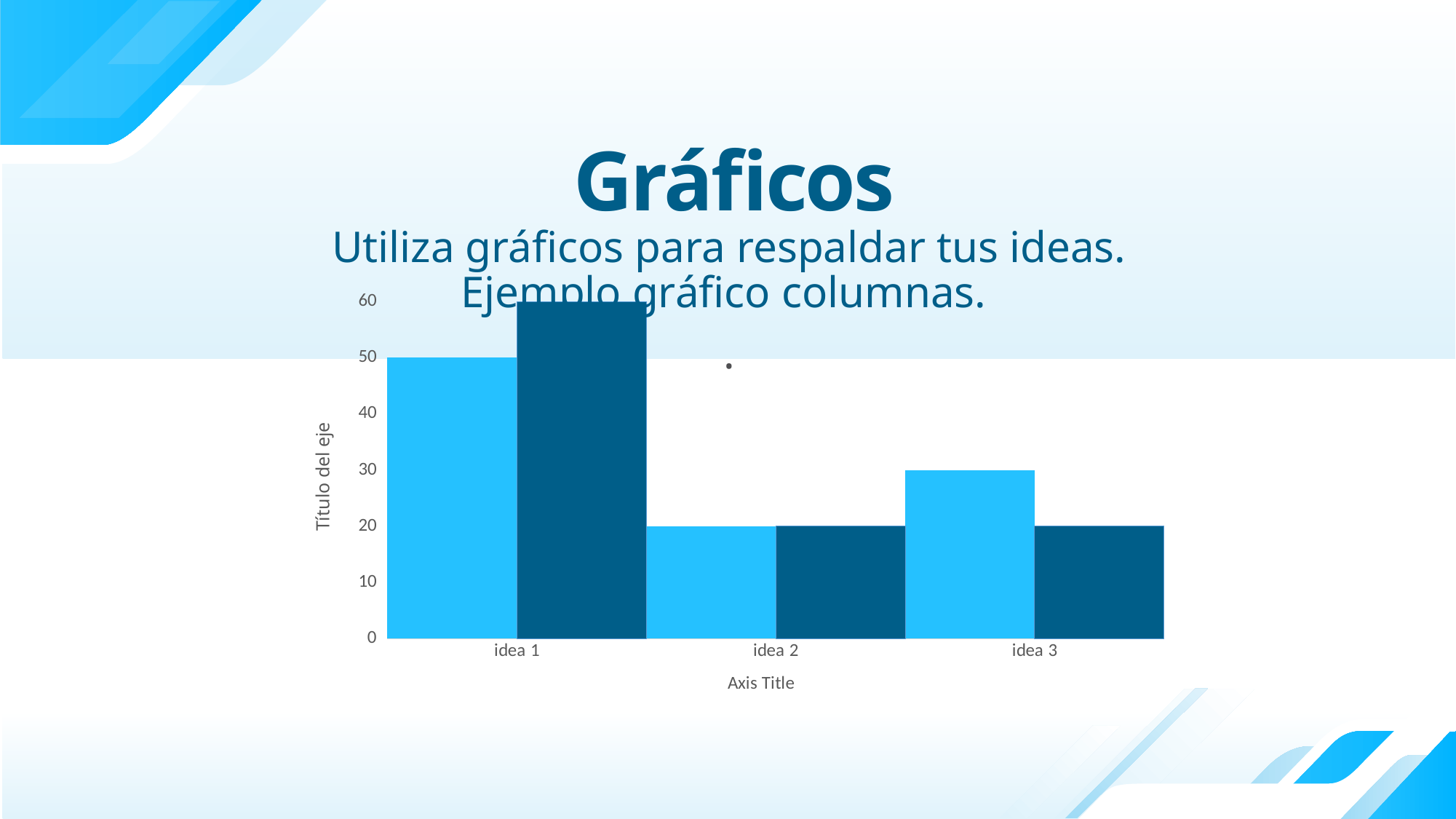
What is the title of the horizontal axis of the chart? Axis Title How many categories are shown on the x axis of the chart? 3 What is the value of the light blue bar for idea 3? 30 Which category has the tallest bar in the chart? idea 1 What is the value of the light blue bar for idea 1? 50 What is the value of the dark blue bar for idea 1? 60 What kind of chart is shown on the slide? bar chart What is the difference between the dark blue bar and the light blue bar for idea 1? 10 Which is larger: the light blue bar for idea 1 or the light blue bar for idea 3? idea 1 What is the title of the vertical axis of the chart? Título del eje Is the value of the light blue bar for idea 2 greater or less than 30? less Does the dark blue series rise or fall from idea 1 to idea 2? fall